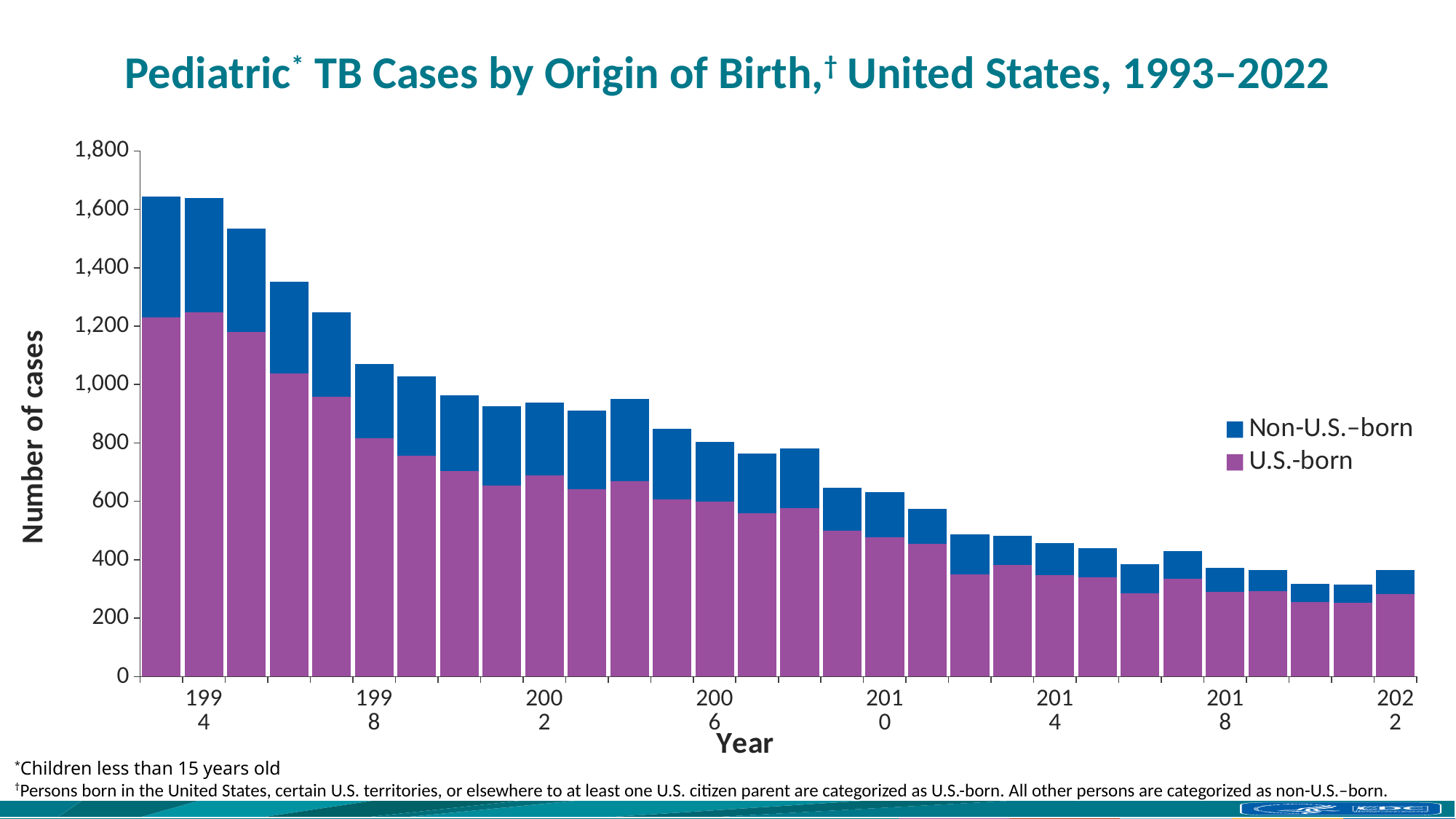
How many years (bars) are plotted in the chart? 30 Which year has the larger total number of cases, 1998 or 2018? 1998 Do the total pediatric TB cases generally rise or fall from 1993 to 2022? Fall Which two series are listed in the legend? Non-U.S.–born and U.S.-born Is the total number of cases for 2014 greater or less than 600? less What kind of chart is shown on the slide? Stacked bar chart Is the total number of cases for 2022 greater or less than 400? less How many series does the legend list? 2 Is the total number of cases for 2002 greater or less than 800? greater What is the label on the vertical axis? Number of cases